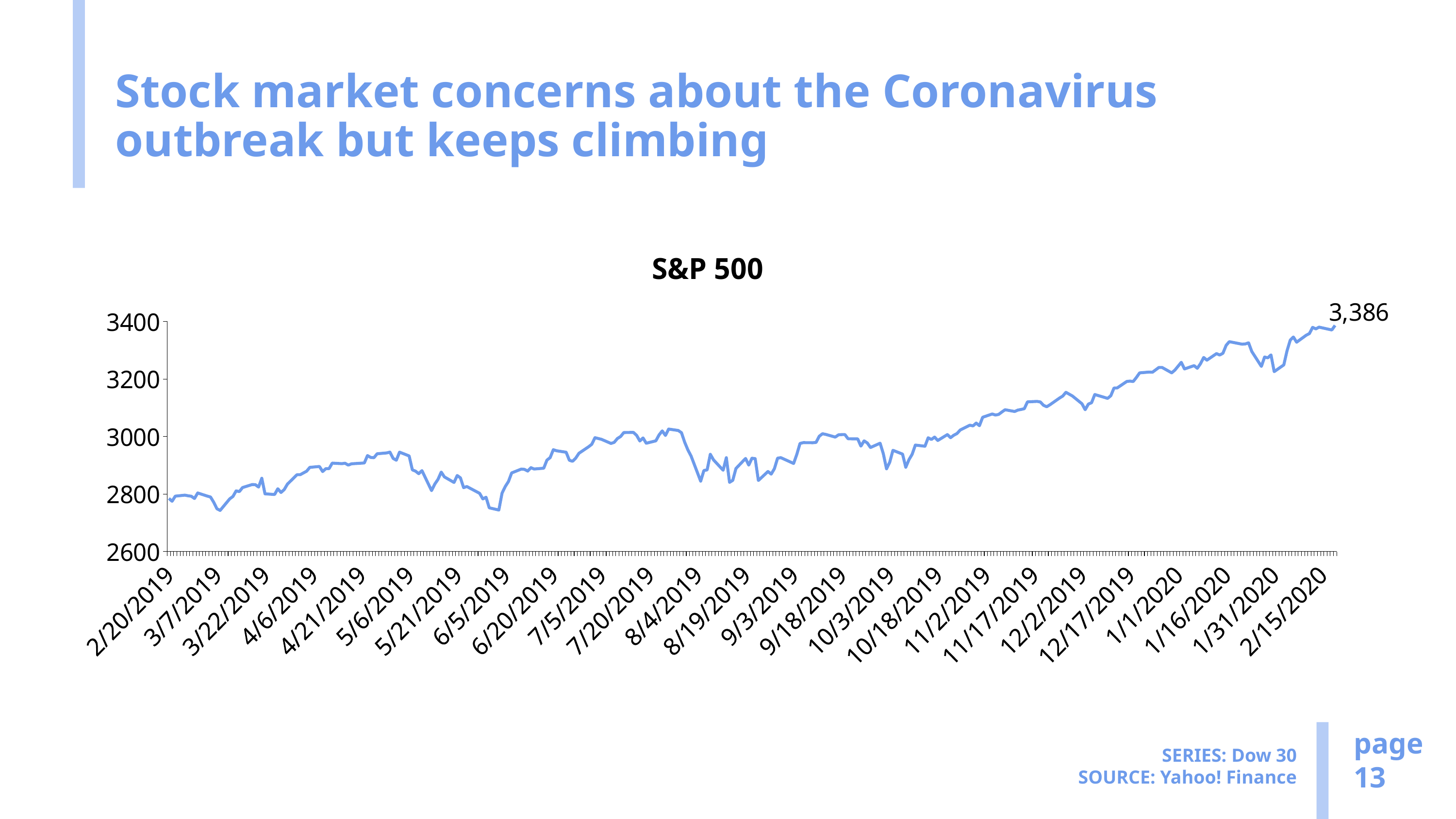
Is the value at 1/1/2020 greater or less than 3000? greater Which is larger, the value at 2/20/2019 or the value at 2/15/2020? 2/15/2020 Is the value at 10/3/2019 greater or less than 3000? less Which is larger, the value at 12/17/2019 or the value at 10/3/2019? 12/17/2019 What is the lowest value shown on the vertical axis? 2600 What kind of chart is shown on the slide? Line chart What is the title of the chart? S&P 500 Does the highest point of the line occur at the start or at the end of the period shown? End Is the value at 2/20/2019 greater or less than 3000? less What value is printed as the data label at the end of the line? 3,386 Overall, does the S&P 500 line rise or fall from left to right across the chart? Rises